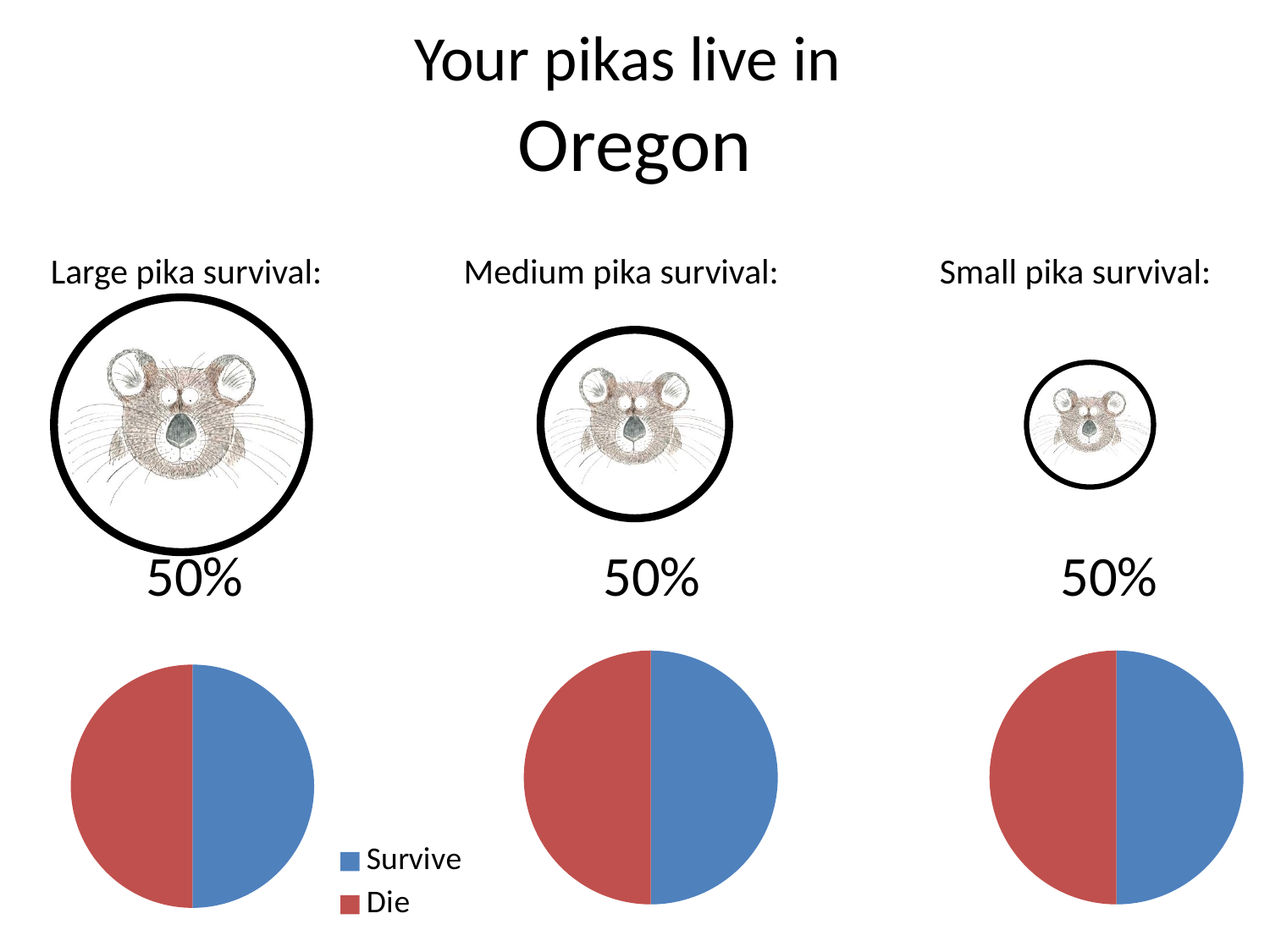
How many slices does the "Medium pika survival:" pie chart have? 2 How many entries does the legend list for the pie charts? 2 In the "Medium pika survival:" pie chart, what share of pikas survive? 50% In the "Small pika survival:" pie chart, what share of pikas survive? 50% In the "Large pika survival:" pie chart, what share of pikas survive? 50% What kind of chart is used under "Large pika survival:"? pie chart How many pie charts are shown on the slide? 3 Which colour represents "Die" in the pie charts' legend? red What is the survival percentage printed above the "Large pika survival:" pie chart? 50% Which colour represents "Survive" in the pie charts' legend? blue What is the difference between the survival percentages printed for large pikas and small pikas? 0%